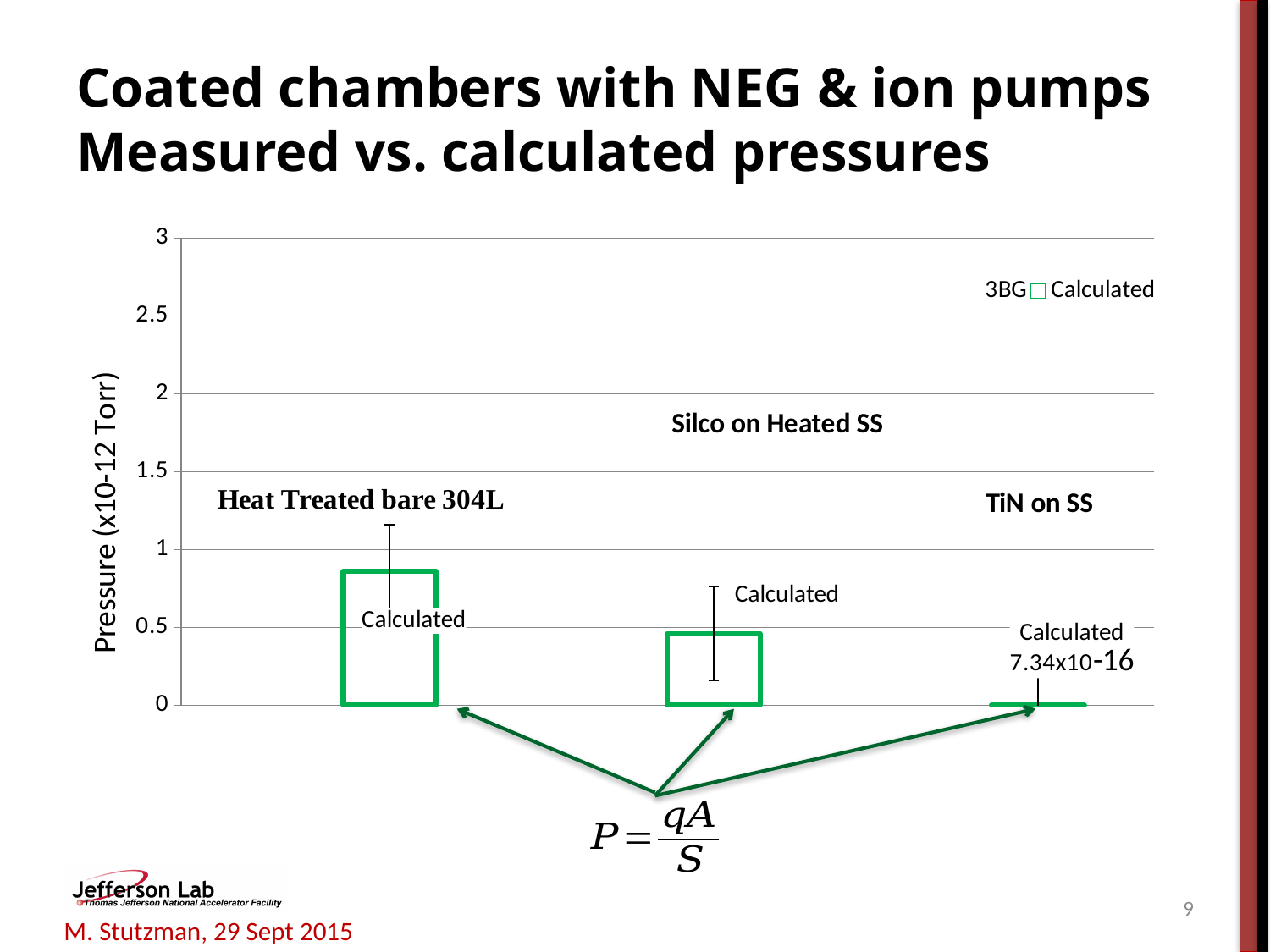
Which chamber has the highest calculated pressure? Heat Treated bare 304L Which chamber has the lowest calculated pressure? TiN on SS How many series does the chart legend list? 2 Is the calculated pressure for Silco on Heated SS greater or less than 1? less What calculated pressure value is printed for TiN on SS? 7.34x10-16 What is the label of the chart's vertical axis? Pressure (x10-12 Torr) What kind of chart is shown on the slide? bar chart Is the calculated pressure for Heat Treated bare 304L greater or less than 1? less How many categories (chambers) are plotted on the chart? 3 Is the calculated pressure for Heat Treated bare 304L greater or less than 0.5? greater Do the calculated pressures rise or fall moving from left to right across the chart? fall Which has a larger calculated pressure, Heat Treated bare 304L or Silco on Heated SS? Heat Treated bare 304L